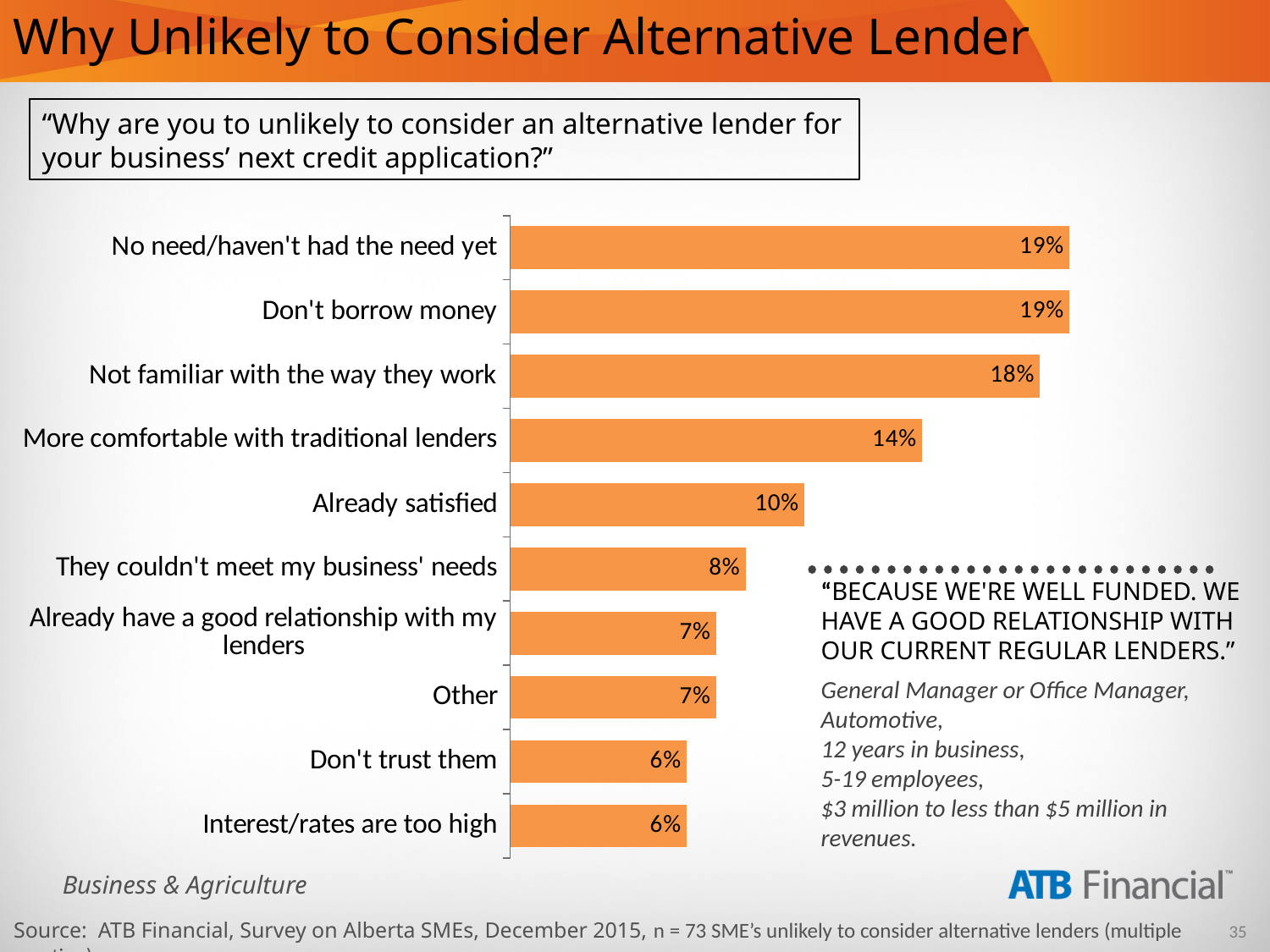
What is the difference between "No need/haven't had the need yet" and "Already satisfied"? 9% How many categories are shown in the chart? 10 What kind of chart is shown on the slide? Bar chart What is the value for "Already satisfied"? 10% What is the value for "More comfortable with traditional lenders"? 14% Do the values increase or decrease going from the top bar to the bottom bar? Decrease What colour are the bars in the chart? Orange What is the value for "Don't trust them"? 6% What percentage of respondents said "Not familiar with the way they work"? 18% Which category has the lowest value, "Already satisfied" or "They couldn't meet my business' needs"? They couldn't meet my business' needs What is the difference between "Not familiar with the way they work" and "Interest/rates are too high"? 12% Which is larger, "More comfortable with traditional lenders" or "Other"? More comfortable with traditional lenders